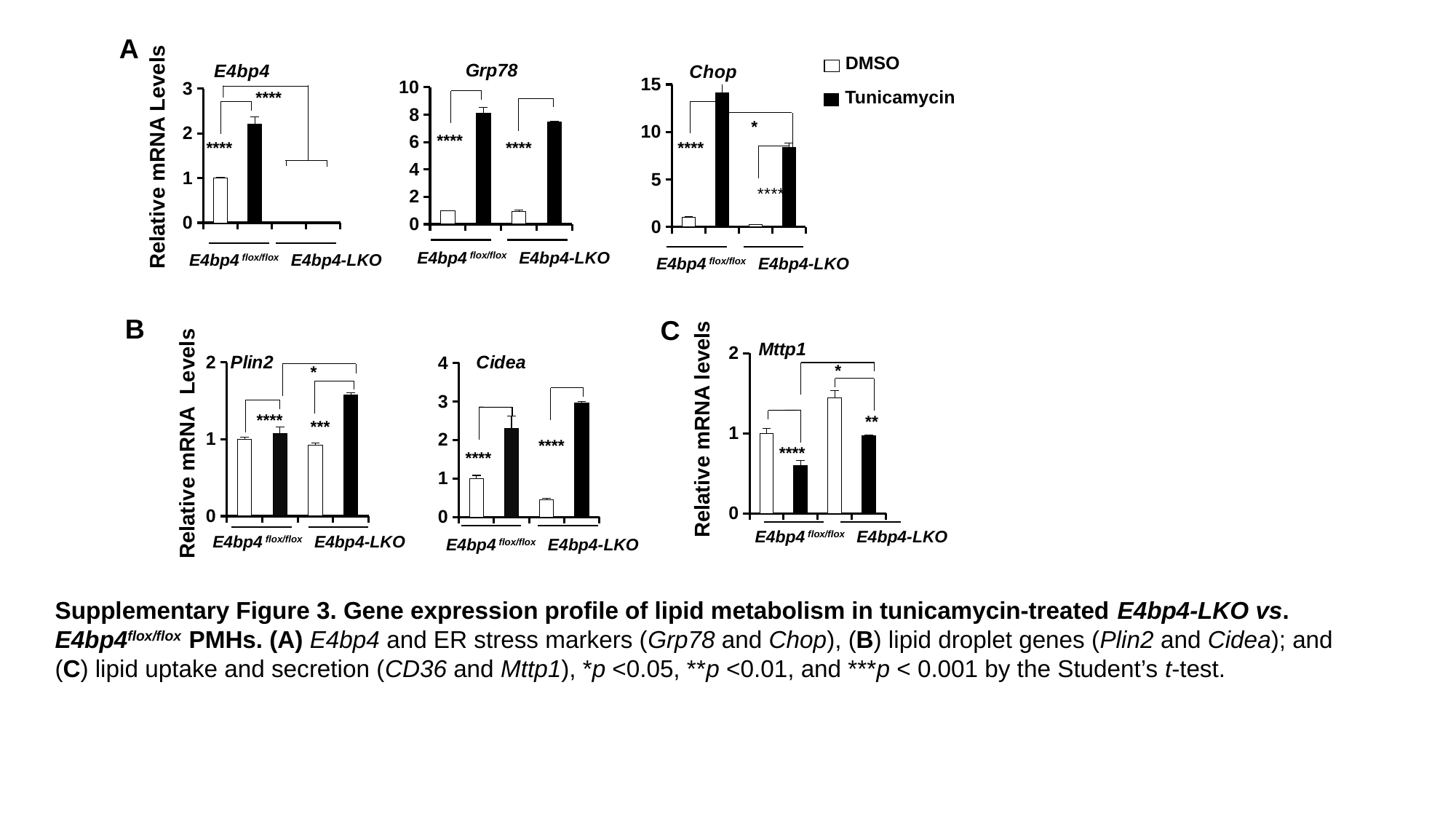
In the Plin2 chart, which bar is the highest? Tunicamycin in E4bp4-LKO In the Mttp1 chart, which bar is the highest? DMSO in E4bp4-LKO In the legend of panel A, which treatment is shown by the black bars? Tunicamycin In the Chop chart, is the Tunicamycin value for E4bp4-LKO greater or less than 5? greater In the Chop chart, which is larger: the Tunicamycin value for E4bp4 flox/flox or the Tunicamycin value for E4bp4-LKO? Tunicamycin value for E4bp4 flox/flox In the Mttp1 chart, which is larger for E4bp4 flox/flox: the DMSO value or the Tunicamycin value? DMSO In the Grp78 chart, is the Tunicamycin value for E4bp4 flox/flox greater or less than 6? greater What kind of chart is the Chop chart in panel A? bar chart In the Chop chart, which bar is the highest? Tunicamycin in E4bp4 flox/flox How many series does the legend in panel A list? 2 In the Cidea chart, is the DMSO value for E4bp4-LKO greater or less than 1? less In the Cidea chart, which bar is the lowest? DMSO in E4bp4-LKO